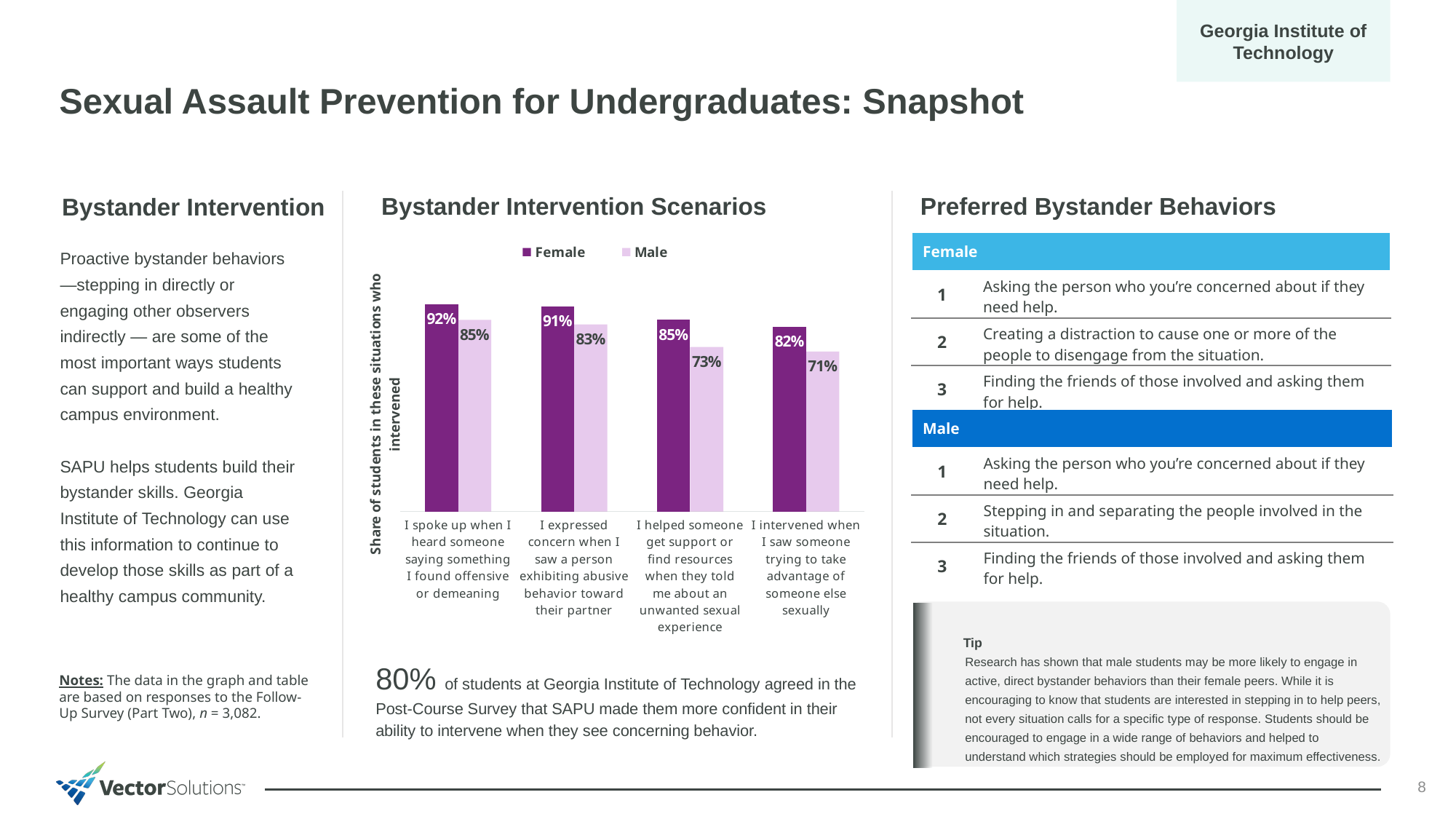
What kind of chart is shown under 'Bystander Intervention Scenarios'? Bar chart Which scenario has the highest Female value? I spoke up when I heard someone saying something I found offensive or demeaning How many scenarios are shown on the x axis of the chart? 4 What is the Male value for 'I helped someone get support or find resources when they told me about an unwanted sexual experience'? 73% Do the Female values rise or fall from left to right across the scenarios? Fall What is the difference between the Female and Male values for 'I expressed concern when I saw a person exhibiting abusive behavior toward their partner'? 8% Which is larger: the Male value for 'I spoke up when I heard someone saying something I found offensive or demeaning' or the Male value for 'I intervened when I saw someone trying to take advantage of someone else sexually'? I spoke up when I heard someone saying something I found offensive or demeaning How many series does the chart legend list? 2 What is the title of the chart on the slide? Bystander Intervention Scenarios What is the Female value for 'I spoke up when I heard someone saying something I found offensive or demeaning'? 92% What is the Male value for 'I intervened when I saw someone trying to take advantage of someone else sexually'? 71% Which scenario has the lowest Male value? I intervened when I saw someone trying to take advantage of someone else sexually